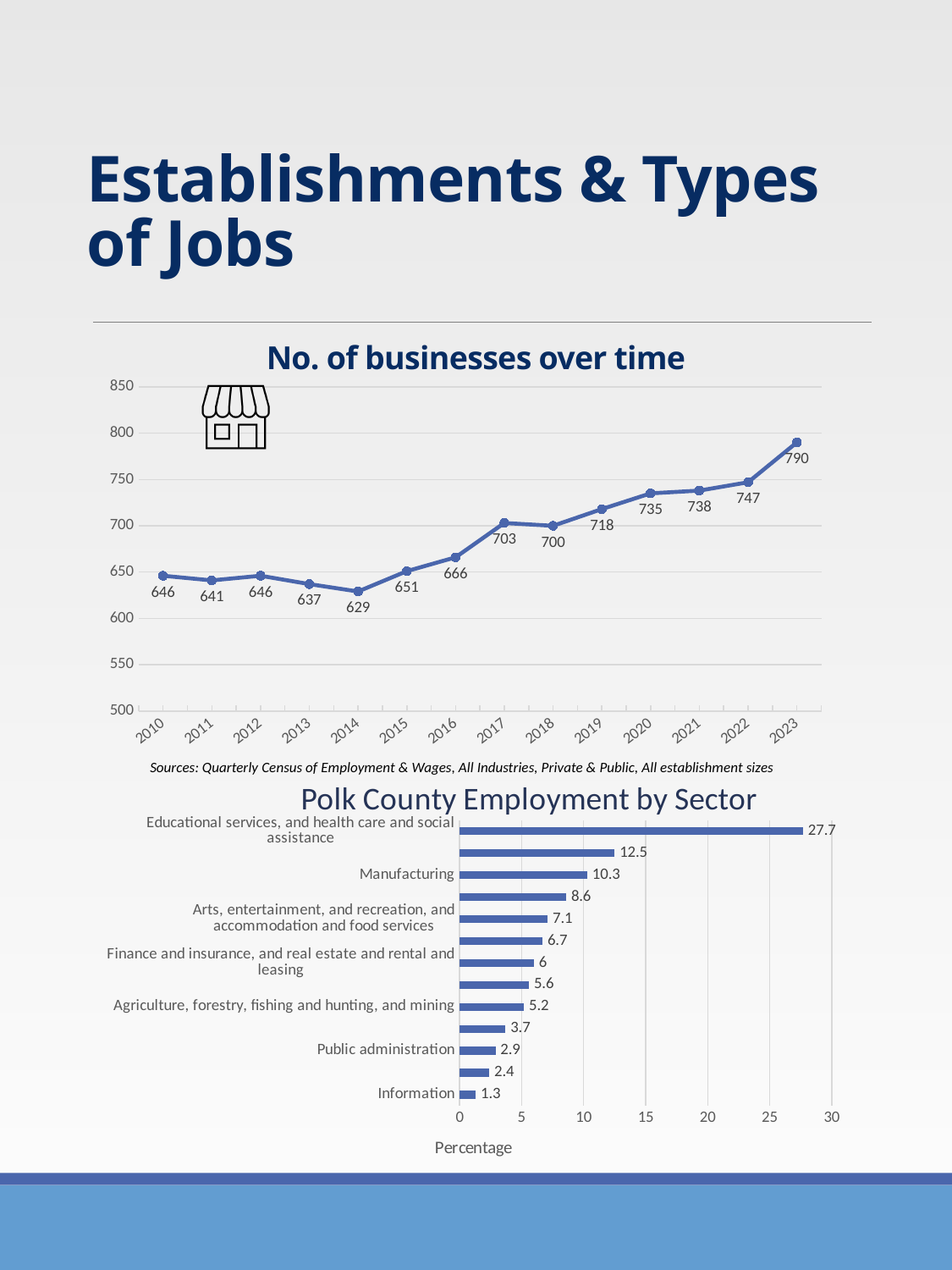
In the 'No. of businesses over time' chart, what is the value for 2023? 790 In the 'Polk County Employment by Sector' chart, which sector has the highest percentage? Educational services, and health care and social assistance In the 'No. of businesses over time' chart, do the values generally rise or fall from 2014 to 2023? Rise In the 'No. of businesses over time' chart, which year has the highest number of businesses? 2023 In the 'No. of businesses over time' chart, which year has the lowest number of businesses? 2014 What kind of chart is 'No. of businesses over time'? Line chart What kind of chart is 'Polk County Employment by Sector'? Bar chart In the 'Polk County Employment by Sector' chart, which is larger: Public administration or Information? Public administration In the 'No. of businesses over time' chart, how many years are plotted? 14 In the 'Polk County Employment by Sector' chart, what is the value for Manufacturing? 10.3 In the 'No. of businesses over time' chart, what is the value for 2014? 629 In the 'No. of businesses over time' chart, what is the difference between the values for 2023 and 2022? 43